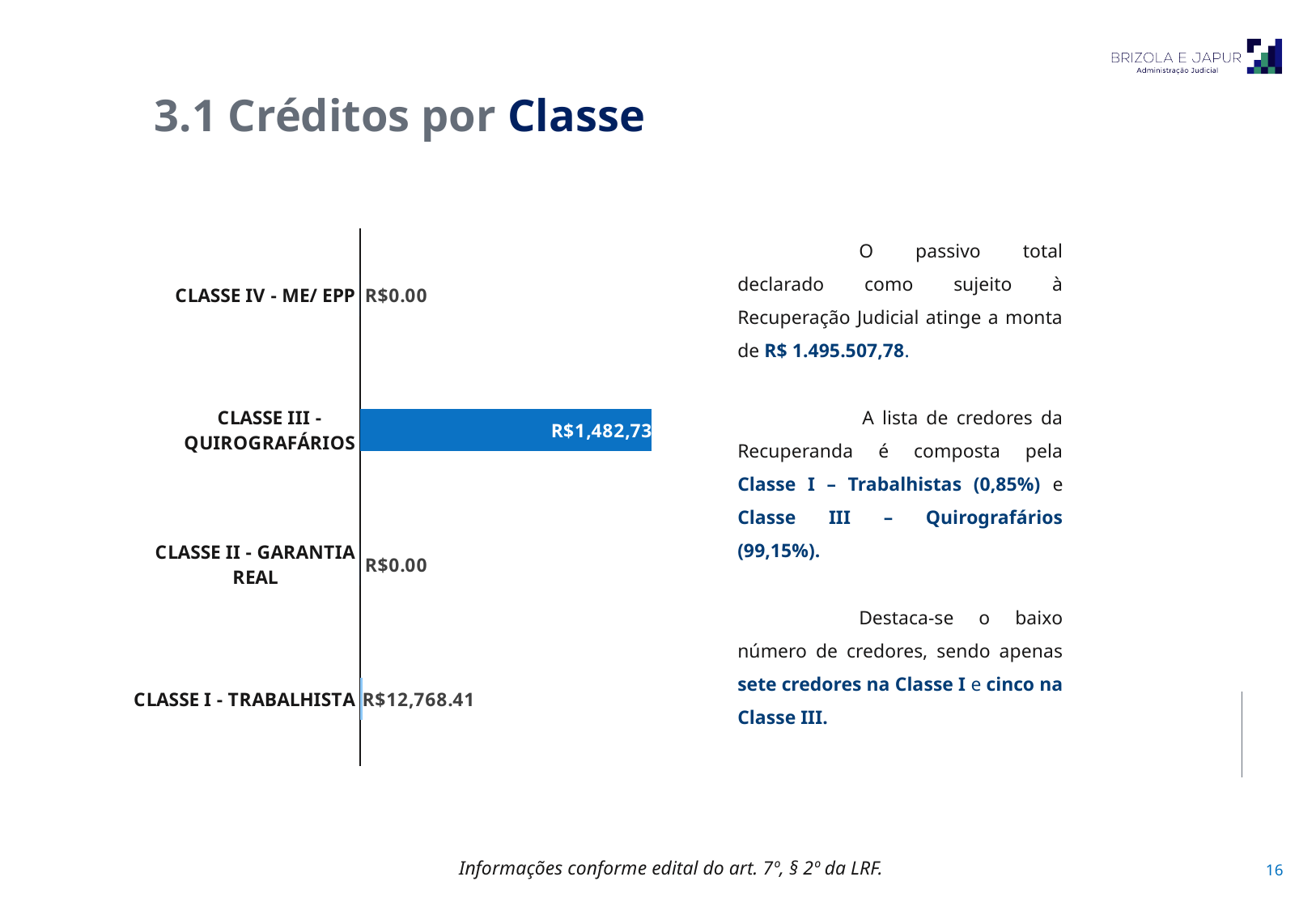
What is the value shown for CLASSE IV - ME/ EPP? R$0.00 What is the title of the slide containing the chart? 3.1 Créditos por Classe What is the value shown for CLASSE II - GARANTIA REAL? R$0.00 What colour is the bar for CLASSE III - QUIROGRAFÁRIOS? Blue Which class has the highest value in the chart? CLASSE III - QUIROGRAFÁRIOS What kind of chart is shown on the slide? Bar chart How many classes (categories) are shown in the chart? 4 Which is larger, the value for CLASSE I - TRABALHISTA or CLASSE II - GARANTIA REAL? CLASSE I - TRABALHISTA How many classes in the chart have a value of R$0.00? 2 What is the value shown for CLASSE I - TRABALHISTA? R$12,768.41 Which is larger, the value for CLASSE III - QUIROGRAFÁRIOS or CLASSE I - TRABALHISTA? CLASSE III - QUIROGRAFÁRIOS What is the difference between the values for CLASSE I - TRABALHISTA and CLASSE II - GARANTIA REAL? R$12,768.41